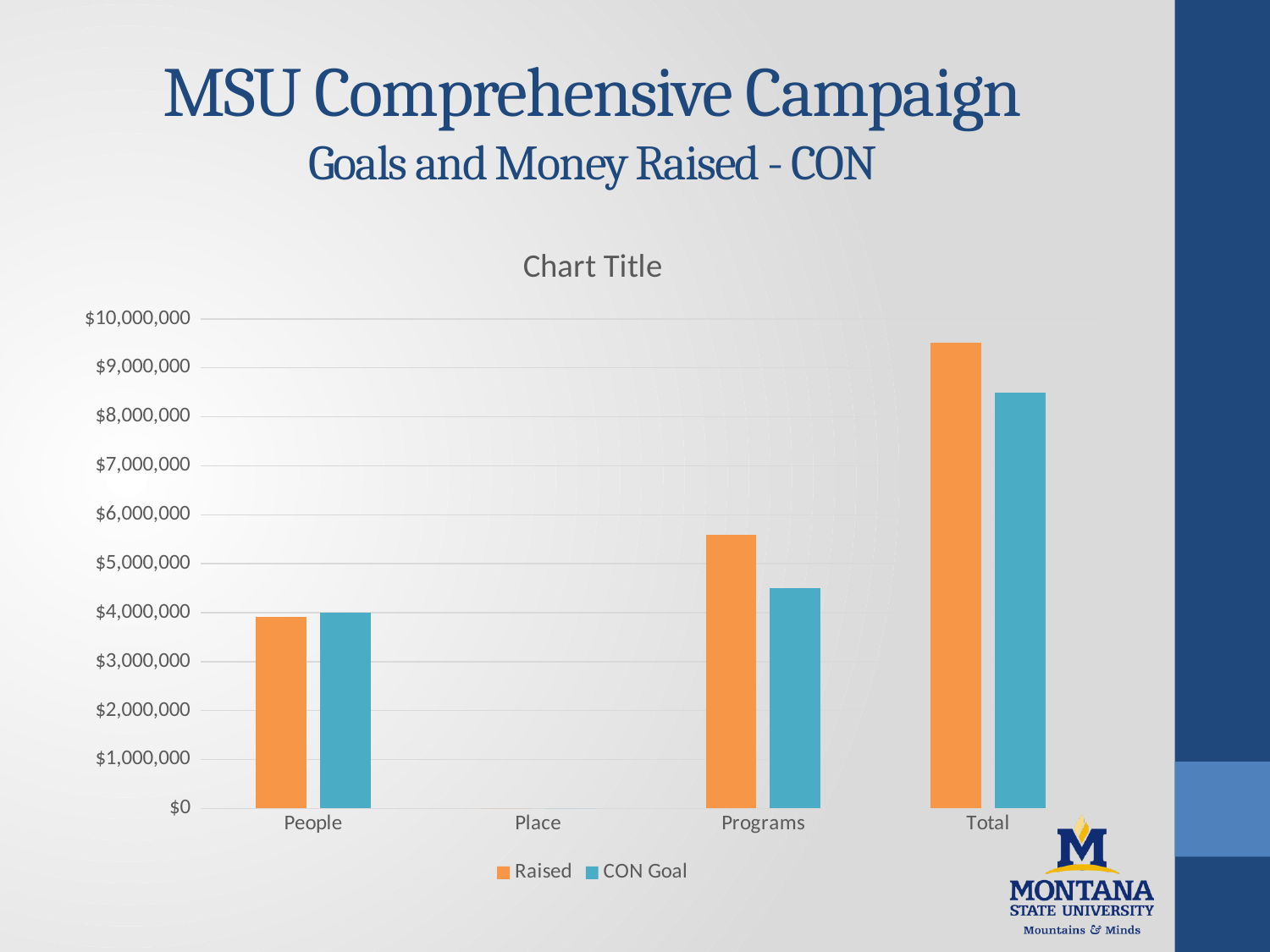
Is the CON Goal value for Total greater or less than $9,000,000? less What kind of chart is shown on the slide? bar chart How many categories are shown on the x axis? 4 Is the CON Goal value for Programs greater or less than $5,000,000? less Is the Raised value for Programs greater or less than $5,000,000? greater Which category shows no bars at all? Place For Programs, which is larger: Raised or CON Goal? Raised Which category has the tallest bar in the chart? Total For Total, which is larger: Raised or CON Goal? Raised How many series does the legend list? 2 Which series is shown in orange in the legend? Raised